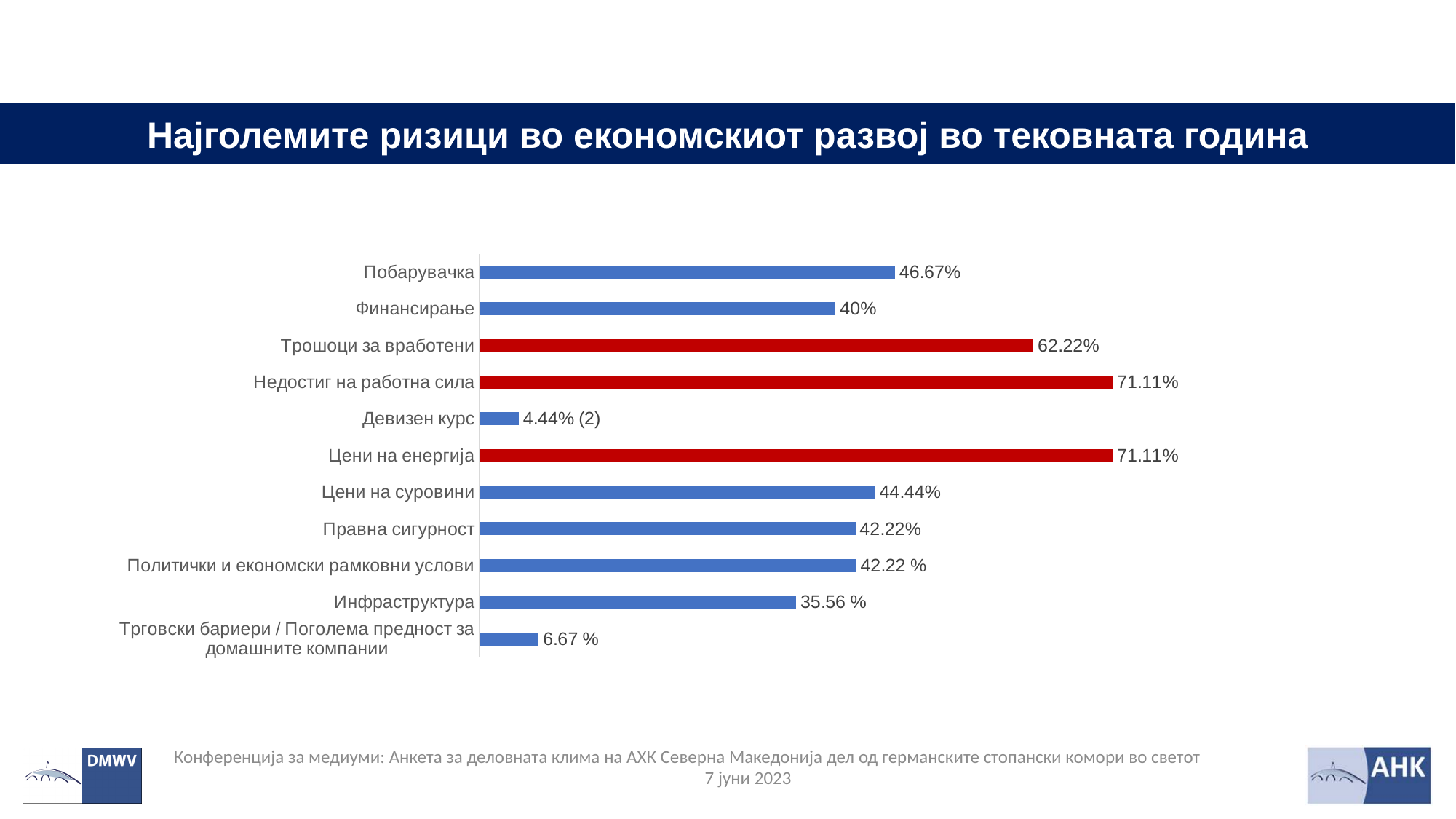
Which two categories share the highest value of 71.11%? Недостиг на работна сила and Цени на енергија What is the value for Цени на суровини? 44.44% What is the value for Инфраструктура? 35.56 % What is the value for Побарувачка? 46.67% What is the difference between the values for Недостиг на работна сила and Девизен курс? 66.67% What is the value for Трошоци за вработени? 62.22% How many bars in the chart are coloured red? 3 Which category has the lowest value? Девизен курс What type of chart is shown on the slide? bar chart How many categories are plotted in the chart? 11 Which is larger, the value for Побарувачка or the value for Правна сигурност? Побарувачка What is the difference between the values for Трошоци за вработени and Финансирање? 22.22%